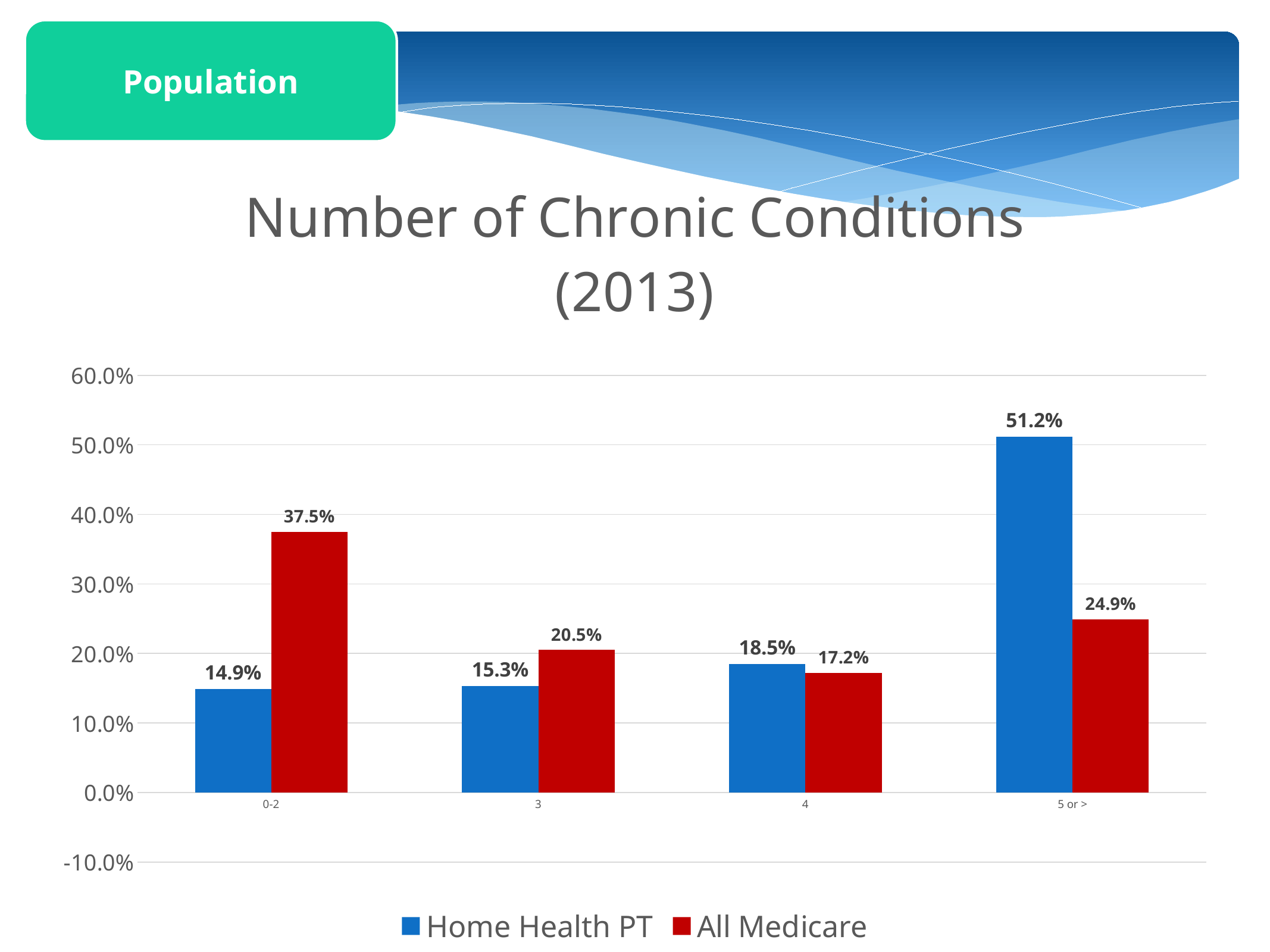
What is the difference between the All Medicare and Home Health PT values for the 0-2 category? 22.6% Which category has the lowest All Medicare value? 4 What kind of chart is shown on the slide? Bar chart What is the difference between the Home Health PT and All Medicare values for the 5 or > category? 26.3% Which category has the highest Home Health PT value? 5 or > How many categories are shown on the x axis? 4 How many series does the legend list? 2 What is the All Medicare value for the 5 or > chronic conditions category? 24.9% What is the title of the chart? Number of Chronic Conditions (2013) For the 4 chronic conditions category, which series has the larger value, Home Health PT or All Medicare? Home Health PT What is the All Medicare value for the 3 chronic conditions category? 20.5% What is the Home Health PT value for the 0-2 chronic conditions category? 14.9%